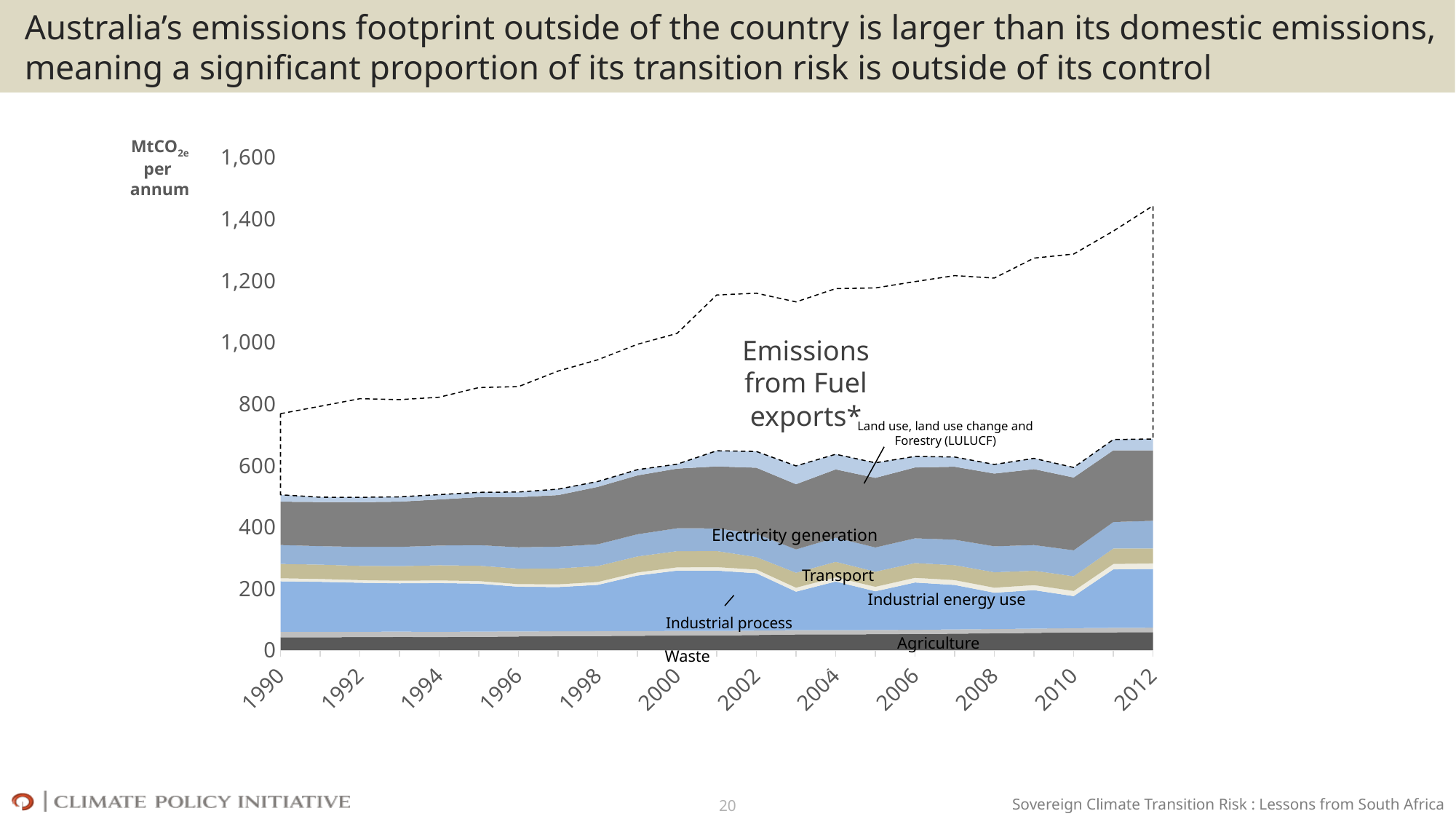
Is the top of the domestic emissions stack (including LULUCF) in 2012 greater or less than 600? greater Is the top of the dashed line in 2012 greater or less than 1,200? greater Which year is the last on the horizontal axis? 2012 Does the dashed line for emissions from fuel exports rise or fall from 1990 to 2012? Rises Which year is the first on the horizontal axis? 1990 Is the top of the dashed line in 1998 greater or less than 1,000? less What unit is shown on the vertical axis of the chart? MtCO2e per annum Which sector band is the thickest in 2012? Electricity generation What is the highest value labelled on the vertical axis? 1,600 What kind of chart is shown on the slide? Stacked area chart How many year labels are shown along the horizontal axis? 12